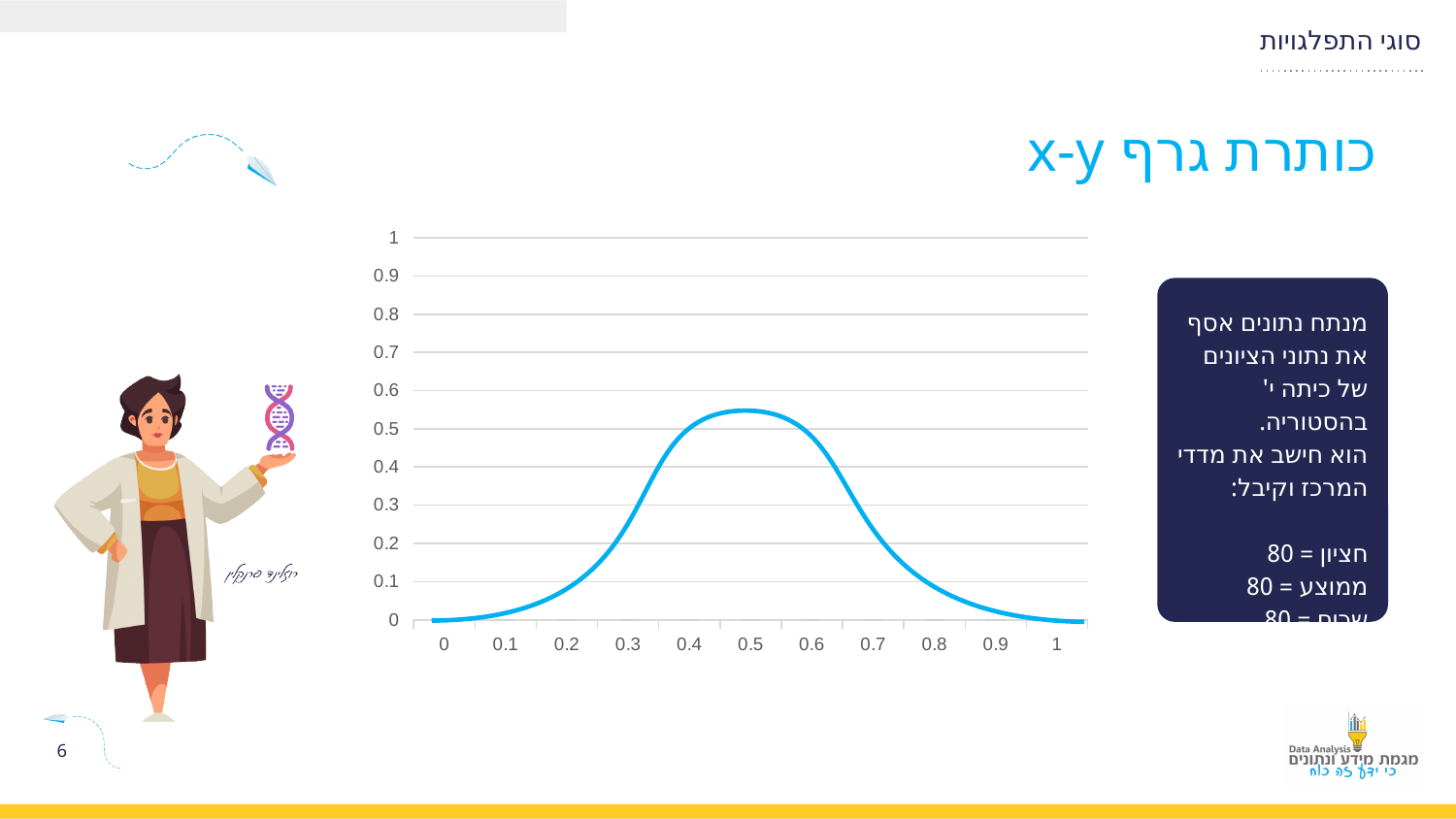
How many tick labels are shown on the x axis? 11 Do the values rise or fall along the x axis from 0.5 to 1? fall Is the peak value of the curve greater or less than 0.4? greater Is the value of the curve at x = 0.2 greater or less than 0.3? less Is the peak value of the curve greater or less than 0.7? less What is the highest value labelled on the y axis? 1 Do the values rise or fall along the x axis from 0 to 0.5? rise Which is larger, the value of the curve at x = 0.4 or at x = 0.9? x = 0.4 What is the title of the chart on the slide? כותרת גרף x-y What kind of chart is shown on the slide? line chart